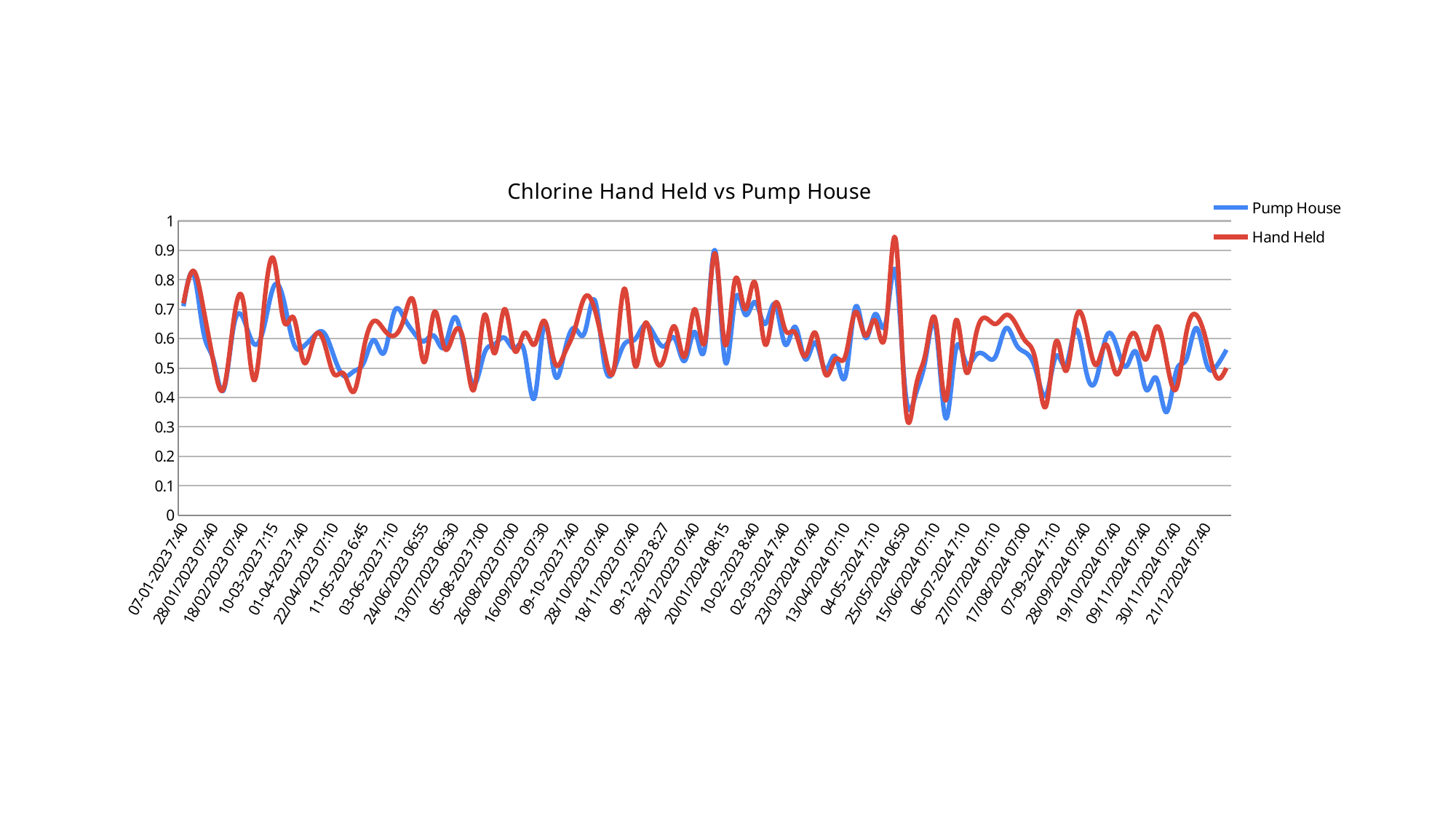
What is the maximum value shown on the y axis? 1 Is the Hand Held value at 10-03-2023 7:15 greater or less than 0.8? greater Is the Pump House value at 20/01/2024 08:15 greater or less than 0.8? less How many series does the legend list? 2 Is the Hand Held value at 25/05/2024 06:50 greater or less than 0.9? less What is the title of the chart? Chlorine Hand Held vs Pump House Which colour is used for the Hand Held series? red Which series reaches the highest value anywhere on the chart, Pump House or Hand Held? Hand Held What kind of chart is shown on the slide? line chart